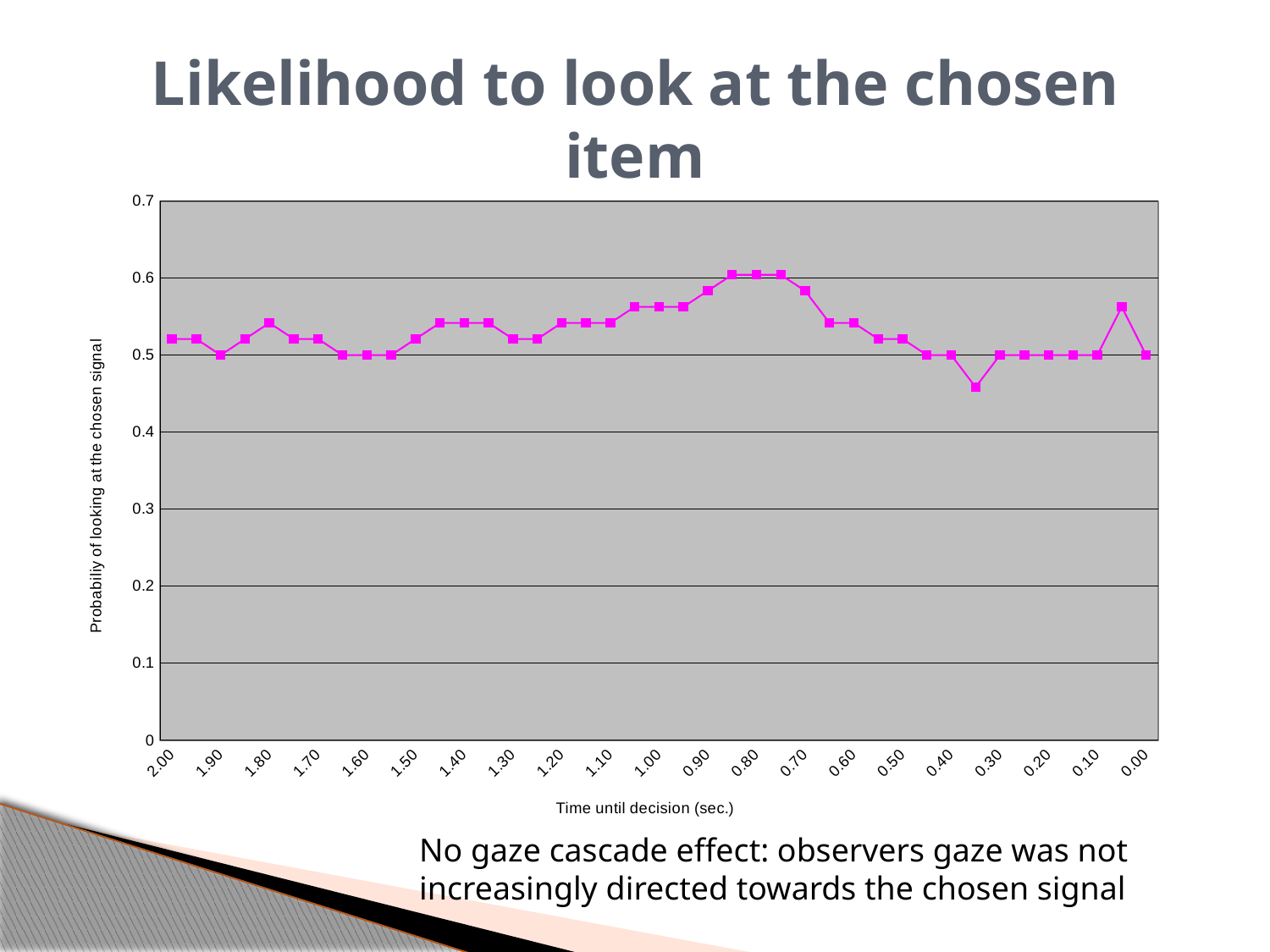
Is the value at time 0.90 greater or less than 0.5? greater Which has the higher value, time 0.80 or time 0.40? 0.80 Is the value at time 1.80 greater or less than 0.6? less Is the value at time 1.00 greater or less than 0.6? less Around which labeled time until decision does the line reach its highest point? 0.80 What is the label of the x axis? Time until decision (sec.) What kind of chart is shown on the slide? line chart What is the title of the chart? Likelihood to look at the chosen item How many time labels are shown along the x axis? 21 Moving from time 1.00 to time 0.80, does the line rise or fall? rise Which has the higher value, time 1.80 or time 1.90? 1.80